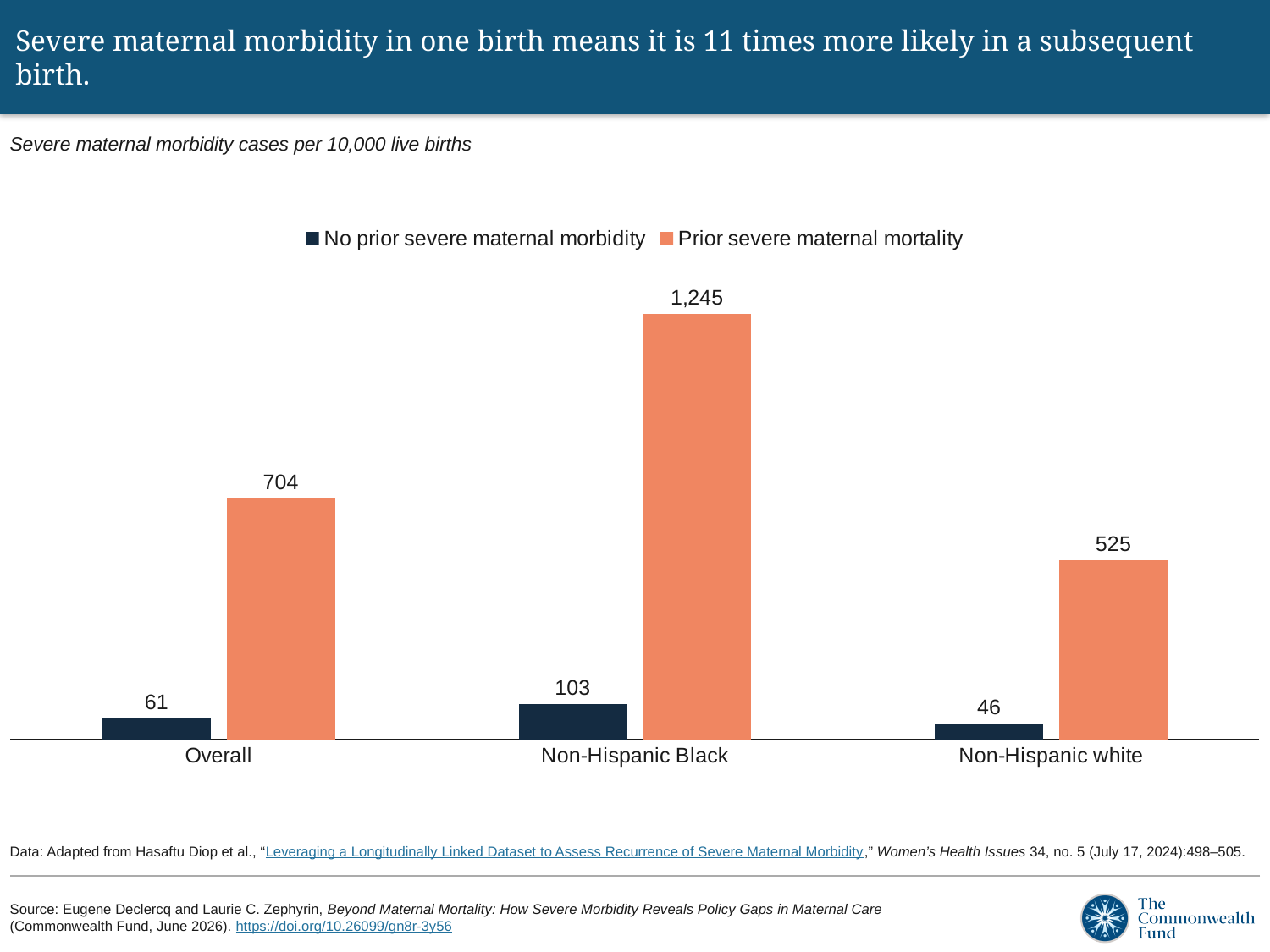
What is the value for Non-Hispanic white in the 'Prior severe maternal mortality' series? 525 What is the difference between the 'Prior severe maternal mortality' and 'No prior severe maternal morbidity' values for Overall? 643 What unit does the chart subtitle say the values are measured in? Severe maternal morbidity cases per 10,000 live births Which is larger: the 'No prior severe maternal morbidity' value for Non-Hispanic Black or for Overall? Non-Hispanic Black How many series does the legend list? 2 How many categories are shown on the x axis? 3 Which category has the lowest value in the 'No prior severe maternal morbidity' series? Non-Hispanic white What is the difference between the Non-Hispanic Black and Non-Hispanic white values in the 'Prior severe maternal mortality' series? 720 What is the value for Overall in the 'No prior severe maternal morbidity' series? 61 Which category has the highest value in the 'Prior severe maternal mortality' series? Non-Hispanic Black What kind of chart is shown on the slide? Bar chart What is the value for Non-Hispanic Black in the 'Prior severe maternal mortality' series? 1,245